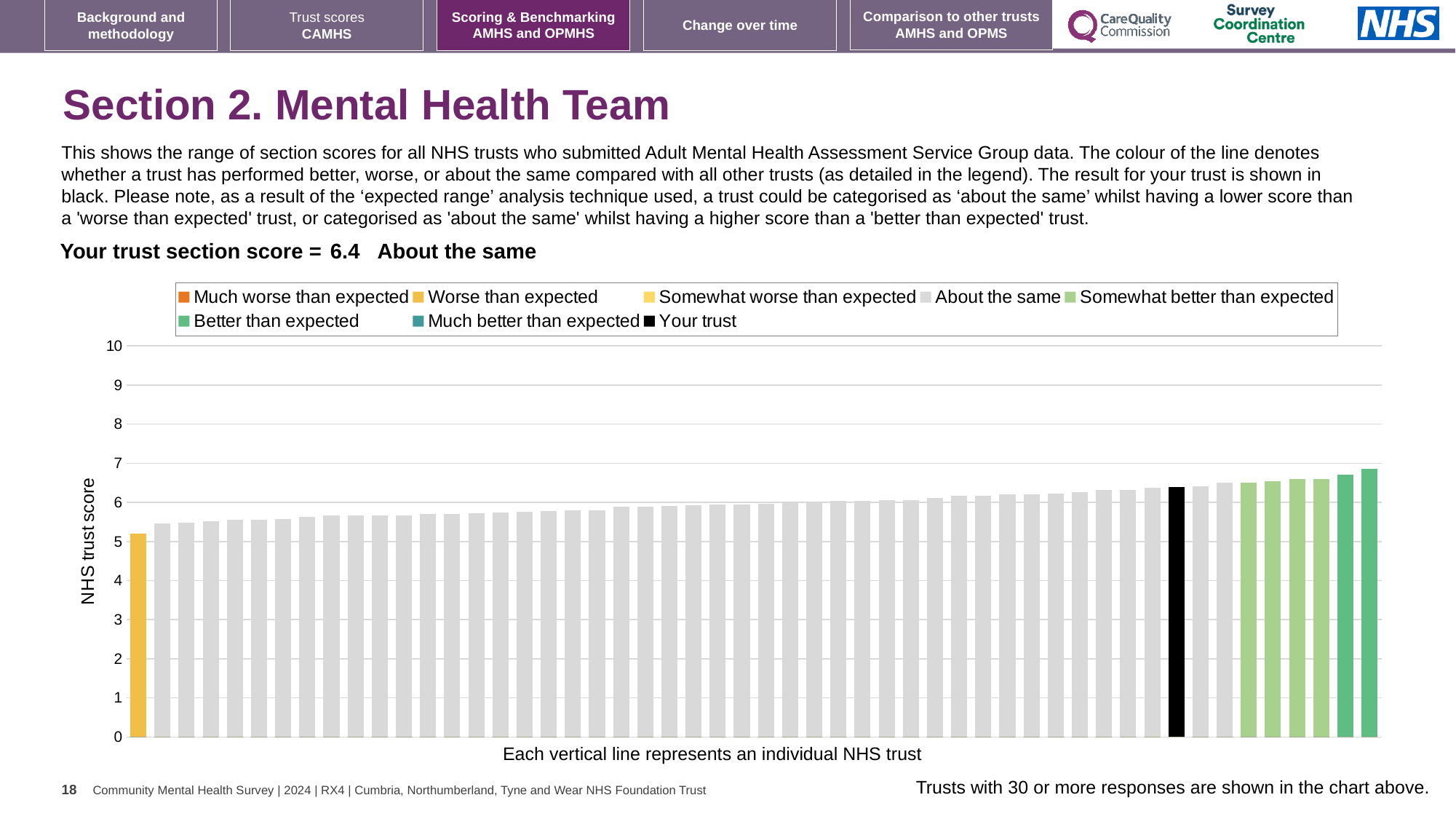
What kind of chart is shown on the slide? bar chart Which is larger, the value for your trust (black bar) or the value for the leftmost yellow bar? your trust (black bar) Which bar is the lowest in the chart, the leftmost or the rightmost? leftmost Do the bar values rise or fall from left to right along the x axis? rise What is the section score for your trust shown on the slide? 6.4 What colour is the bar representing your trust in the chart? black What is the label on the vertical axis of the chart? NHS trust score Is the value for the rightmost bar greater or less than 7? less Is the value for the rightmost bar greater or less than 6? greater Is the value for your trust (the black bar) greater or less than 6? greater How many entries does the chart legend list? 8